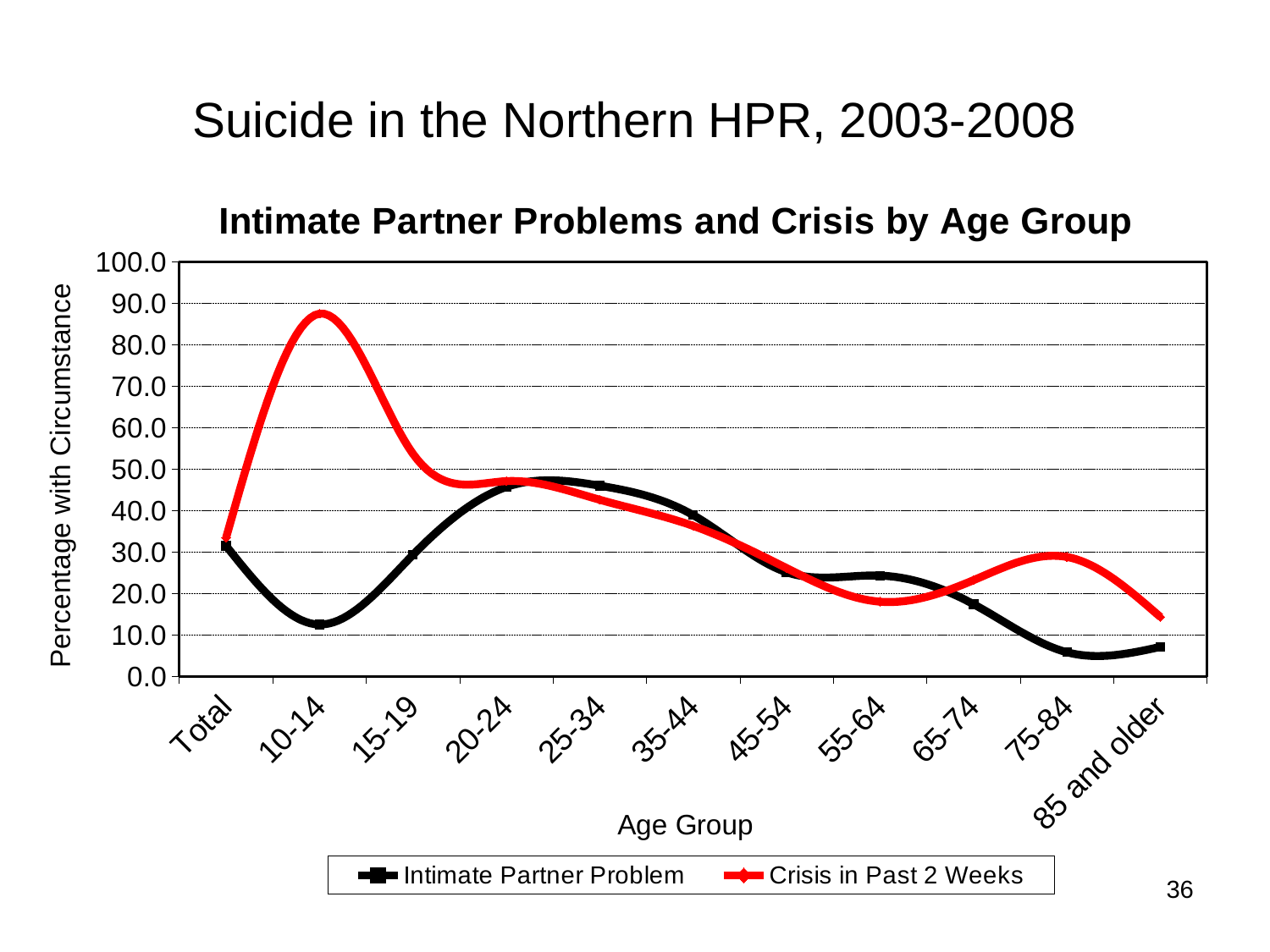
Is the Intimate Partner Problem value for the 85 and older age group greater or less than 10.0? less How many age group categories are shown on the x axis? 11 Does the Intimate Partner Problem line rise or fall from the 25-34 age group to the 75-84 age group? fall Which colour is used for the Crisis in Past 2 Weeks line? red Is the Crisis in Past 2 Weeks value for the 75-84 age group greater or less than 20.0? greater For the 55-64 age group, which series has the larger value: Intimate Partner Problem or Crisis in Past 2 Weeks? Intimate Partner Problem For the 10-14 age group, which series has the larger value: Intimate Partner Problem or Crisis in Past 2 Weeks? Crisis in Past 2 Weeks For which age group is the Crisis in Past 2 Weeks value highest? 10-14 Is the Intimate Partner Problem value for the 10-14 age group greater or less than 20.0? less How many series does the legend list? 2 What kind of chart is shown on the slide? line chart